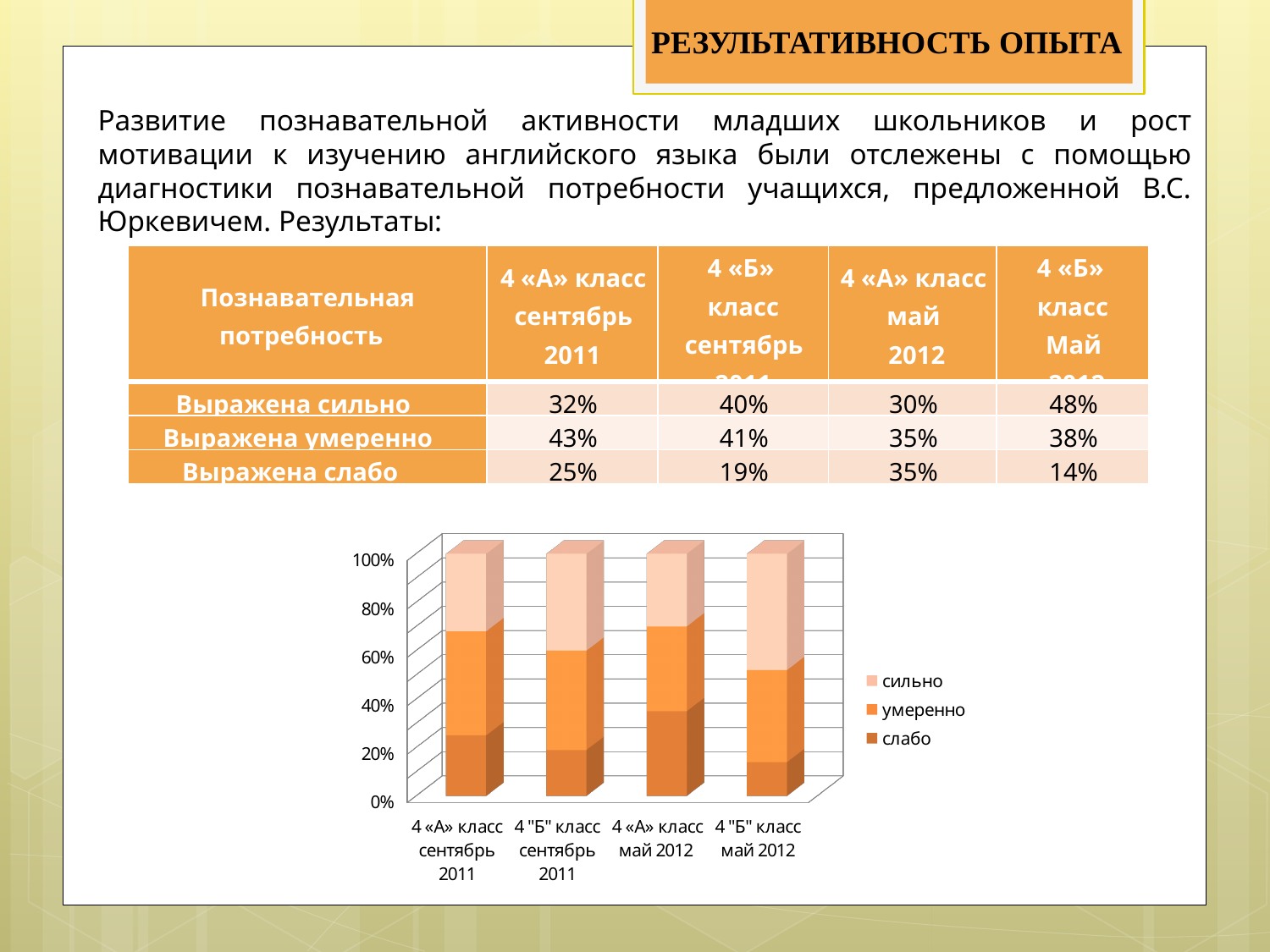
What kind of chart is shown on the slide? stacked bar chart According to the table on the slide, what is the difference between the 'Выражена слабо' values for 4 «А» класс сентябрь 2011 and 4 «Б» класс сентябрь 2011? 6% Which category has the smallest 'слабо' segment in the chart? 4 "Б" класс май 2012 What are the three legend entries of the chart? сильно, умеренно, слабо How many categories are shown along the x axis of the chart? 4 How many series does the chart legend list? 3 Is the 'слабо' segment for 4 "Б" класс май 2012 greater or less than 20%? less According to the table on the slide, what is the 'Выражена сильно' value for 4 «Б» класс май 2012? 48% Is the 'слабо' segment larger for 4 «А» класс май 2012 or for 4 "Б" класс май 2012? 4 «А» класс май 2012 What is the total of each stacked bar in the chart? 100% Which category has the largest 'слабо' segment in the chart? 4 «А» класс май 2012 Is the 'слабо' segment for 4 «А» класс май 2012 greater or less than 20%? greater